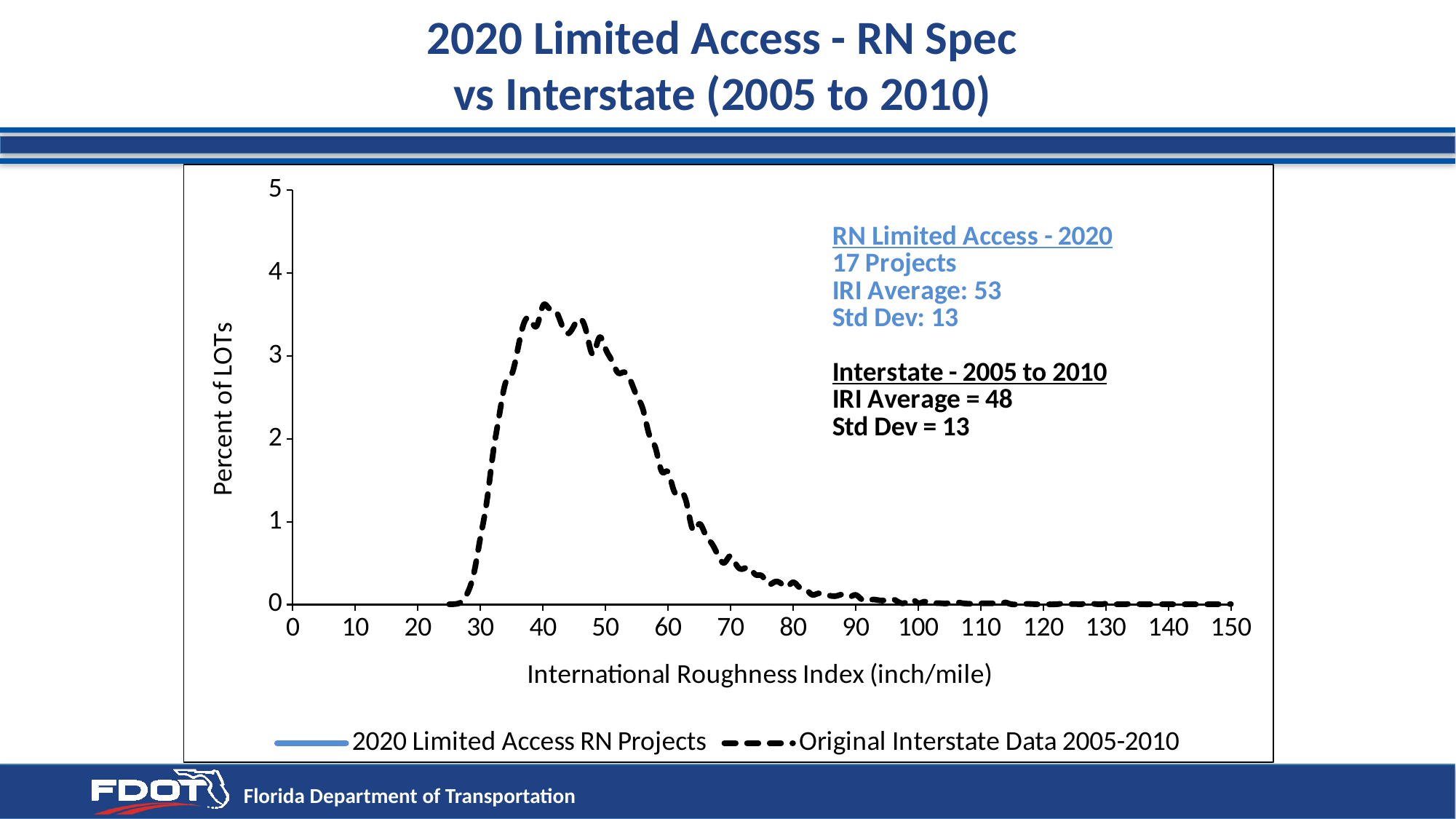
What is the maximum value shown on the y axis? 5 How many series does the legend list? 2 Is the value of the Original Interstate Data 2005-2010 line at an IRI of 30 greater or less than 2? less What is the label of the x axis? International Roughness Index (inch/mile) Does the Original Interstate Data 2005-2010 line rise or fall between an IRI of 60 and an IRI of 90? fall What is the label of the y axis? Percent of LOTs Is the value of the Original Interstate Data 2005-2010 line at an IRI of 50 greater or less than 2? greater What kind of chart is shown on the slide? line chart Does the Original Interstate Data 2005-2010 line rise or fall between an IRI of 25 and an IRI of 40? rise Is the value of the Original Interstate Data 2005-2010 line at an IRI of 40 greater or less than 3? greater